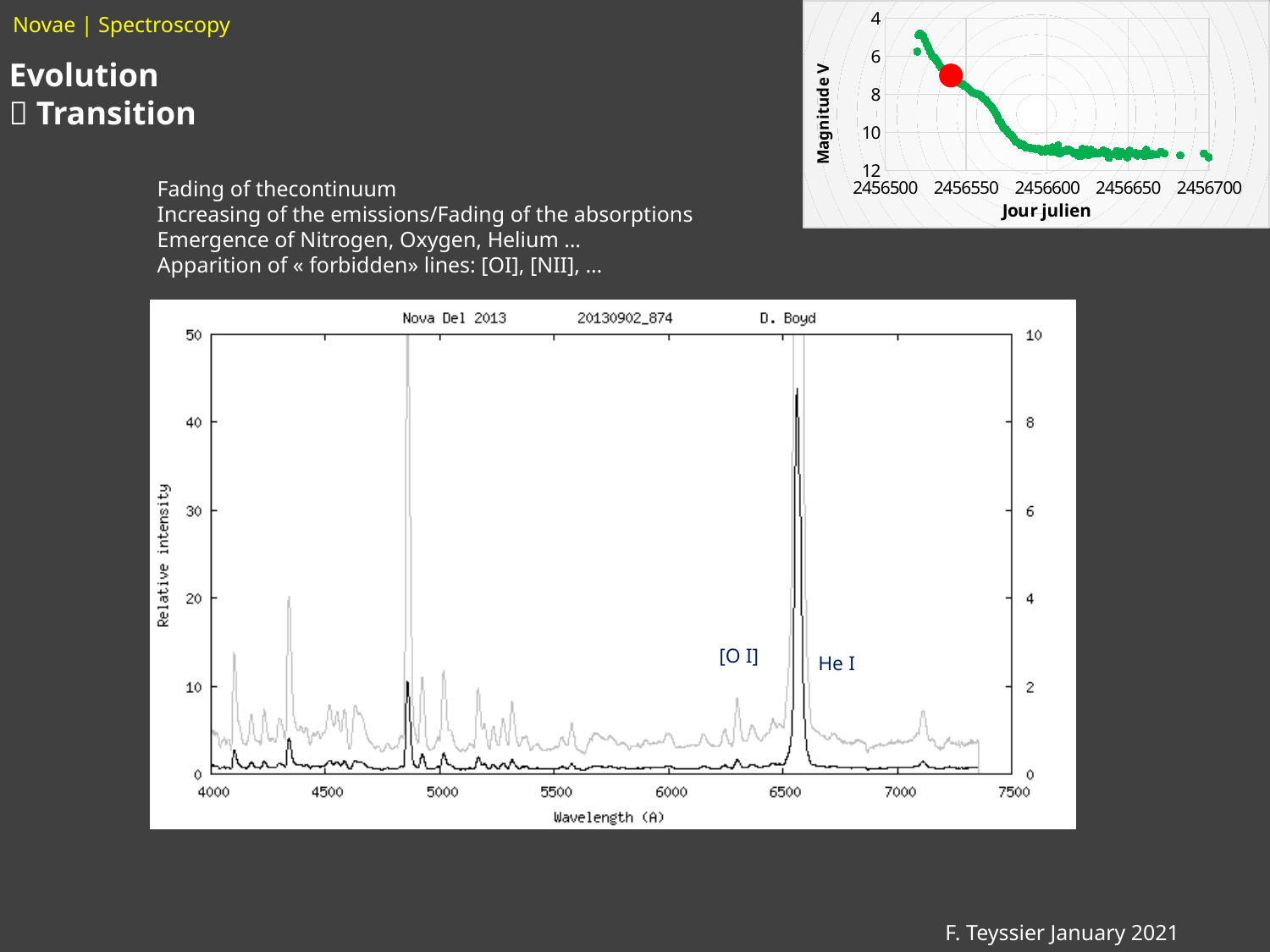
In the bottom Nova Del 2013 chart, is the peak of the black line near wavelength 4340 greater or less than 10 on the left Relative intensity axis? less In the top-right Magnitude V chart, is the Magnitude V value of the green points near Jour julien 2456650 greater or less than 10? greater In the top-right Magnitude V chart, is the Magnitude V value of the red dot greater or less than 8? less In the bottom Nova Del 2013 chart, which two spectral lines are annotated with labels on the plot? [O I] and He I What kind of chart is the top-right chart with Magnitude V on the vertical axis? scatter chart In the top-right Magnitude V chart, what is the label of the horizontal axis? Jour julien In the top-right Magnitude V chart, how many tick labels are shown on the Jour julien axis? 5 In the top-right Magnitude V chart, do the Magnitude V values of the green points increase or decrease as Jour julien increases? increase What kind of chart is the bottom chart titled Nova Del 2013? line chart In the bottom Nova Del 2013 chart, what is the label of the horizontal axis? Wavelength (A)